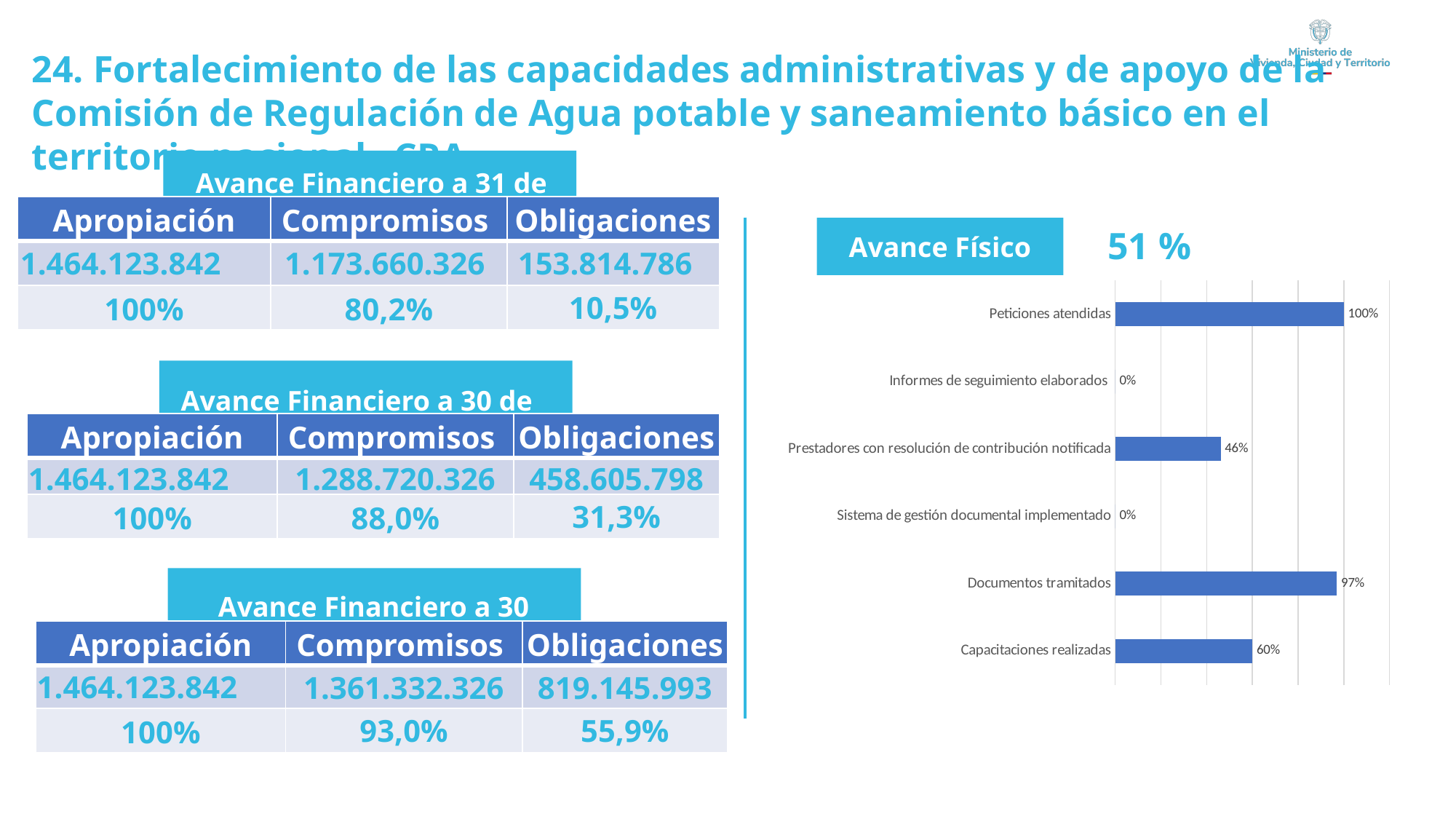
In the Avance Físico chart, what is the value for Peticiones atendidas? 100% In the Avance Físico chart, which is larger: Documentos tramitados or Capacitaciones realizadas? Documentos tramitados How many categories are plotted in the Avance Físico chart? 6 What overall percentage is displayed next to the "Avance Físico" heading above the chart? 51 % In the Avance Físico chart, what is the difference between Capacitaciones realizadas and Prestadores con resolución de contribución notificada? 14 percentage points In the Avance Físico chart, what is the value for Prestadores con resolución de contribución notificada? 46% In the Avance Físico chart, what is the value for Documentos tramitados? 97% In the Avance Físico chart, what is the difference between Peticiones atendidas and Documentos tramitados? 3 percentage points What kind of chart is shown under the heading "Avance Físico"? Bar chart In the Avance Físico chart, what is the value for Capacitaciones realizadas? 60% In the Avance Físico chart, what is the value for Informes de seguimiento elaborados? 0% In the Avance Físico chart, which category has the highest value? Peticiones atendidas